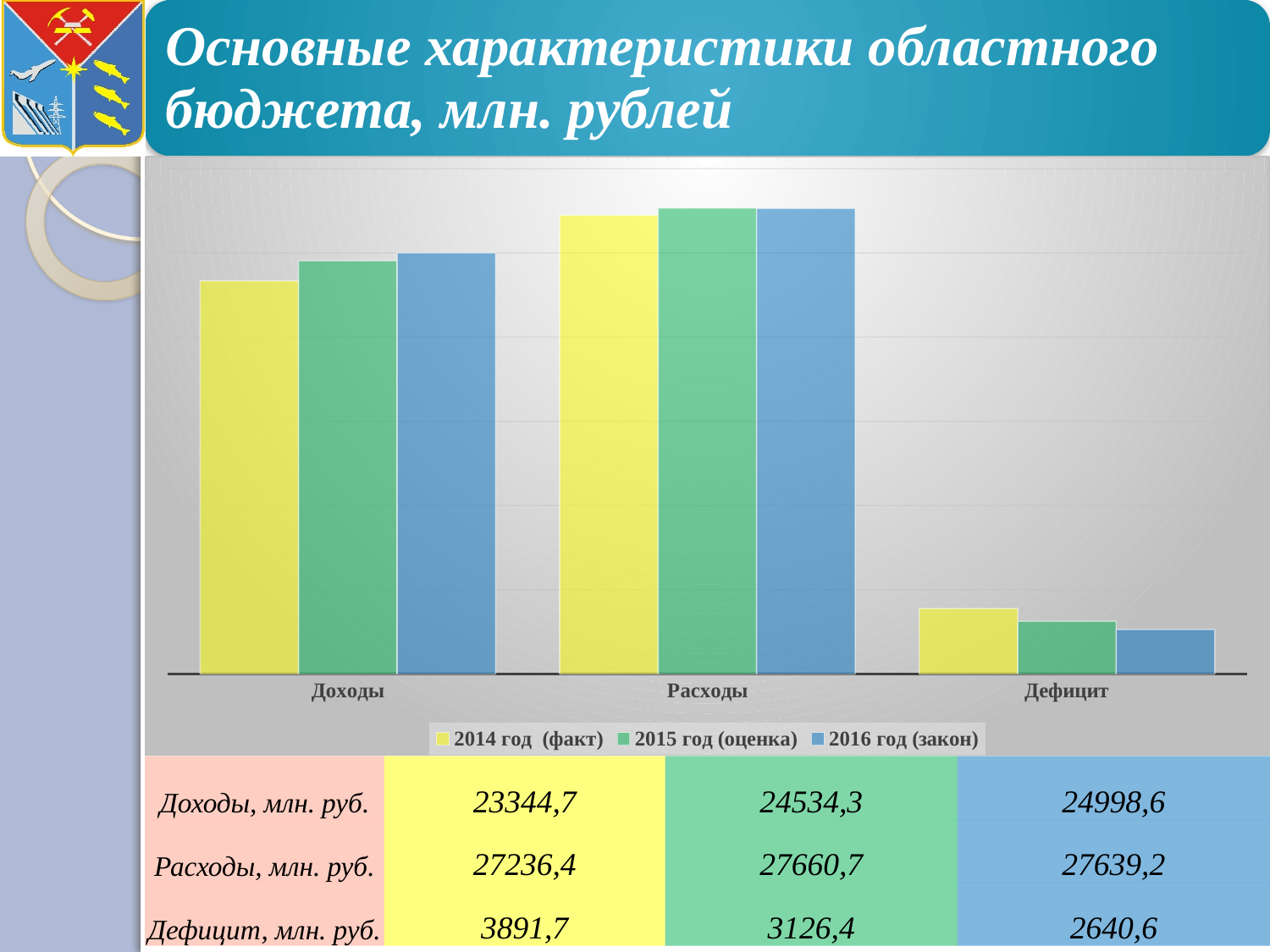
What type of chart is shown on the slide? bar chart Which is larger: Доходы for 2014 год (факт) or Доходы for 2016 год (закон)? 2016 год (закон) How many series does the chart legend list? 3 Which year has the highest value for Дефицит? 2014 год (факт) Which category has the lowest values in the chart? Дефицит What is the title of the slide containing the chart? Основные характеристики областного бюджета, млн. рублей Do the values for Дефицит rise or fall from 2014 to 2016? fall What is the difference between Доходы for 2016 год (закон) and Доходы for 2014 год (факт)? 1653,9 How many categories are shown on the x axis of the chart? 3 What is the value of Дефицит for 2016 год (закон)? 2640,6 What is the value of Расходы for 2015 год (оценка)? 27660,7 What is the value of Доходы for 2014 год (факт)? 23344,7